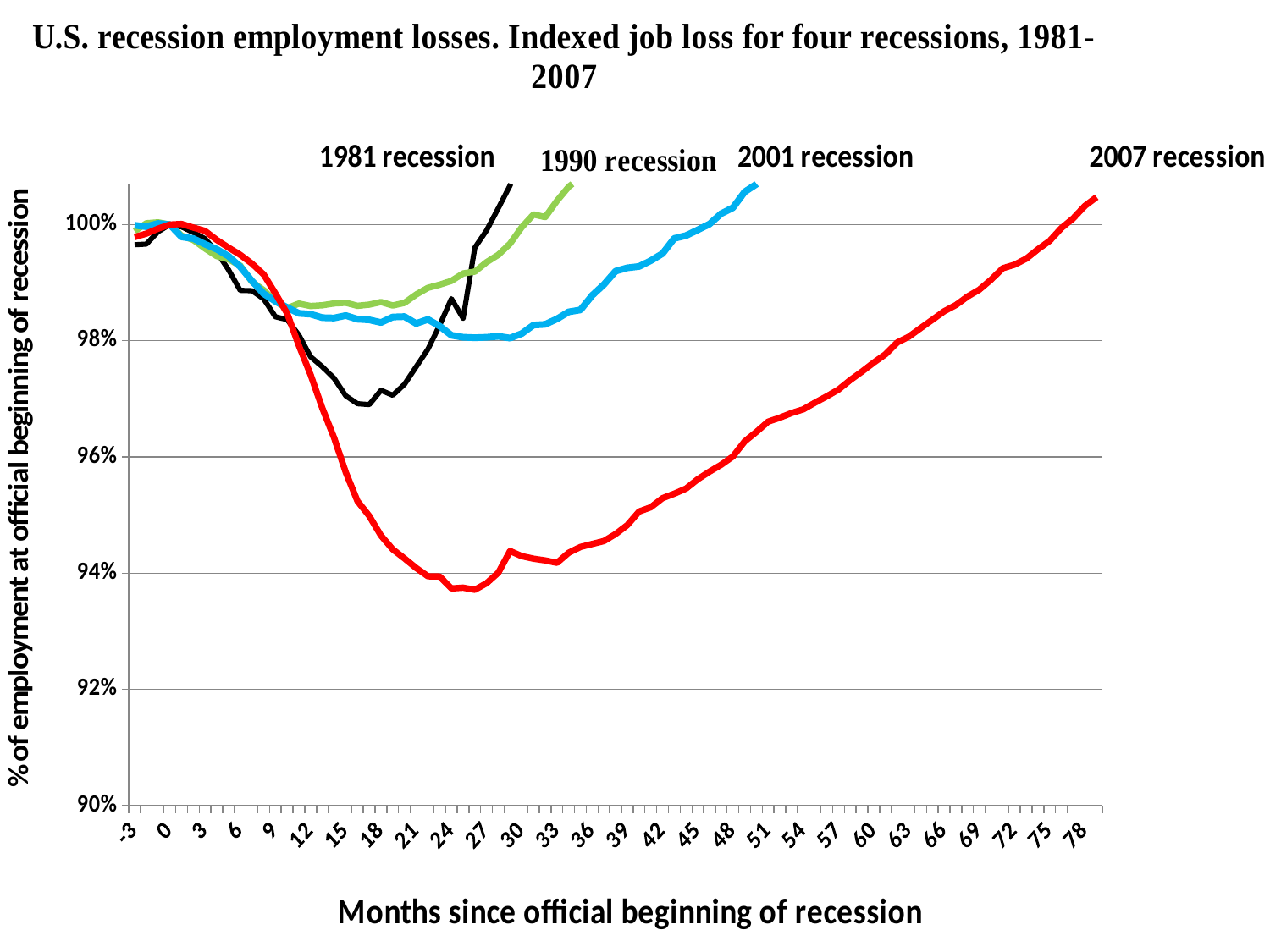
Is the lowest point of the 2007 recession line greater or less than 94%? less At month 24, which line is higher: the 1990 recession or the 2001 recession? 1990 recession What is the label of the vertical axis? % of employment at official beginning of recession How many recession series are plotted on the chart? 4 Which recession's line reaches the lowest employment level? 2007 recession What colour is the line for the 2001 recession? blue Which recession takes the longest number of months to return to 100% employment? 2007 recession What kind of chart is shown on the slide? line chart At month 18, which line is higher: the 1981 recession or the 2007 recession? 1981 recession Is the lowest point of the 1981 recession line greater or less than 96%? greater Is the lowest point of the 1990 recession line greater or less than 98%? greater